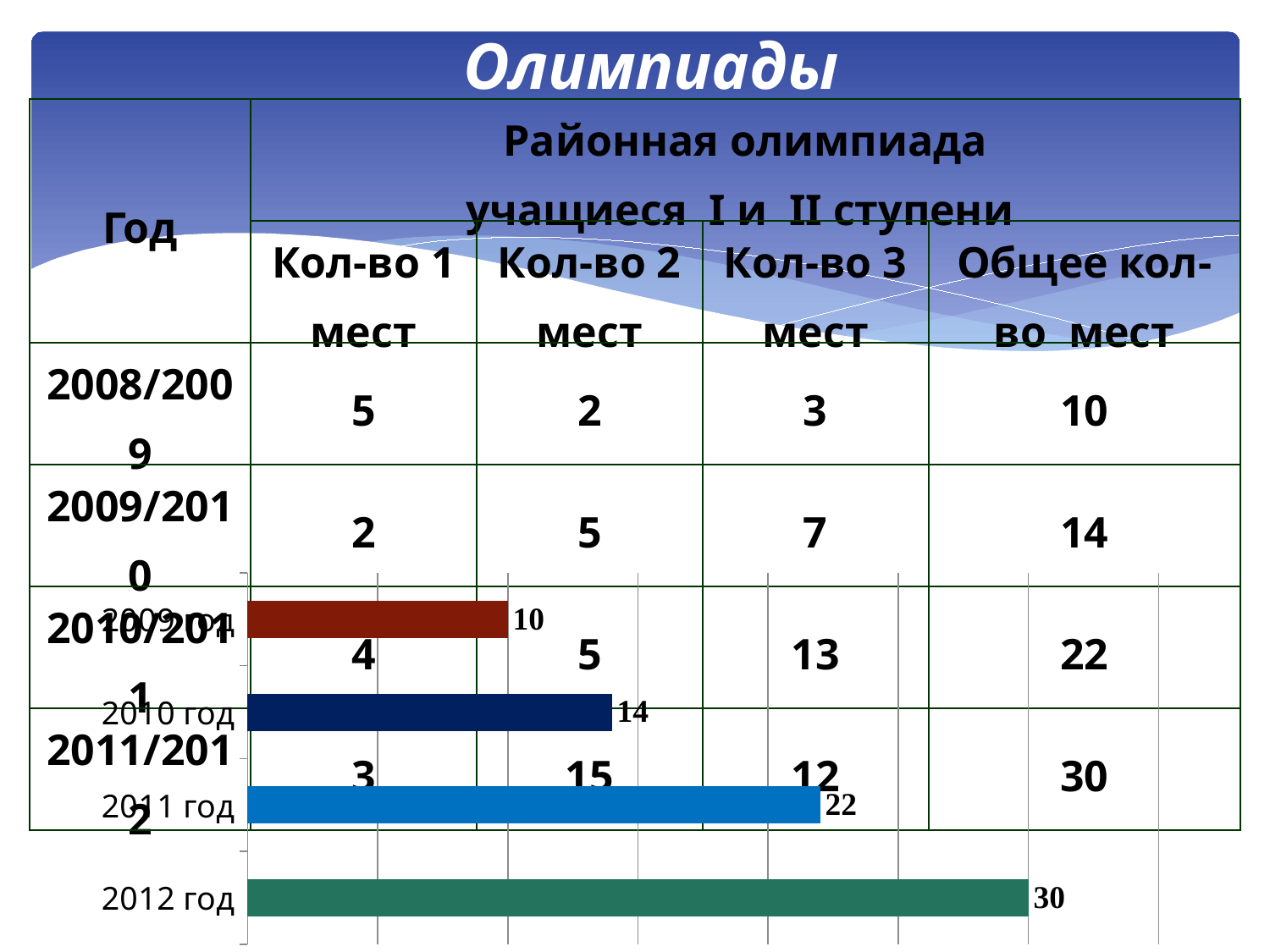
What is the difference between the values for 2011 год and 2010 год in the bar chart? 8 Which year has the lowest value in the bar chart? 2009 год Which year has the highest value in the bar chart? 2012 год What is the value for 2012 год in the bar chart? 30 How many categories (years) does the bar chart show? 4 What is the value for 2011 год in the bar chart? 22 What is the difference between the values for 2012 год and 2009 год in the bar chart? 20 Which is larger in the bar chart, the value for 2010 год or the value for 2011 год? 2011 год What type of chart is shown on the slide? bar chart Do the values in the bar chart rise or fall from 2009 год to 2012 год? rise What is the value for 2010 год in the bar chart? 14 What is the value for 2009 год in the bar chart? 10